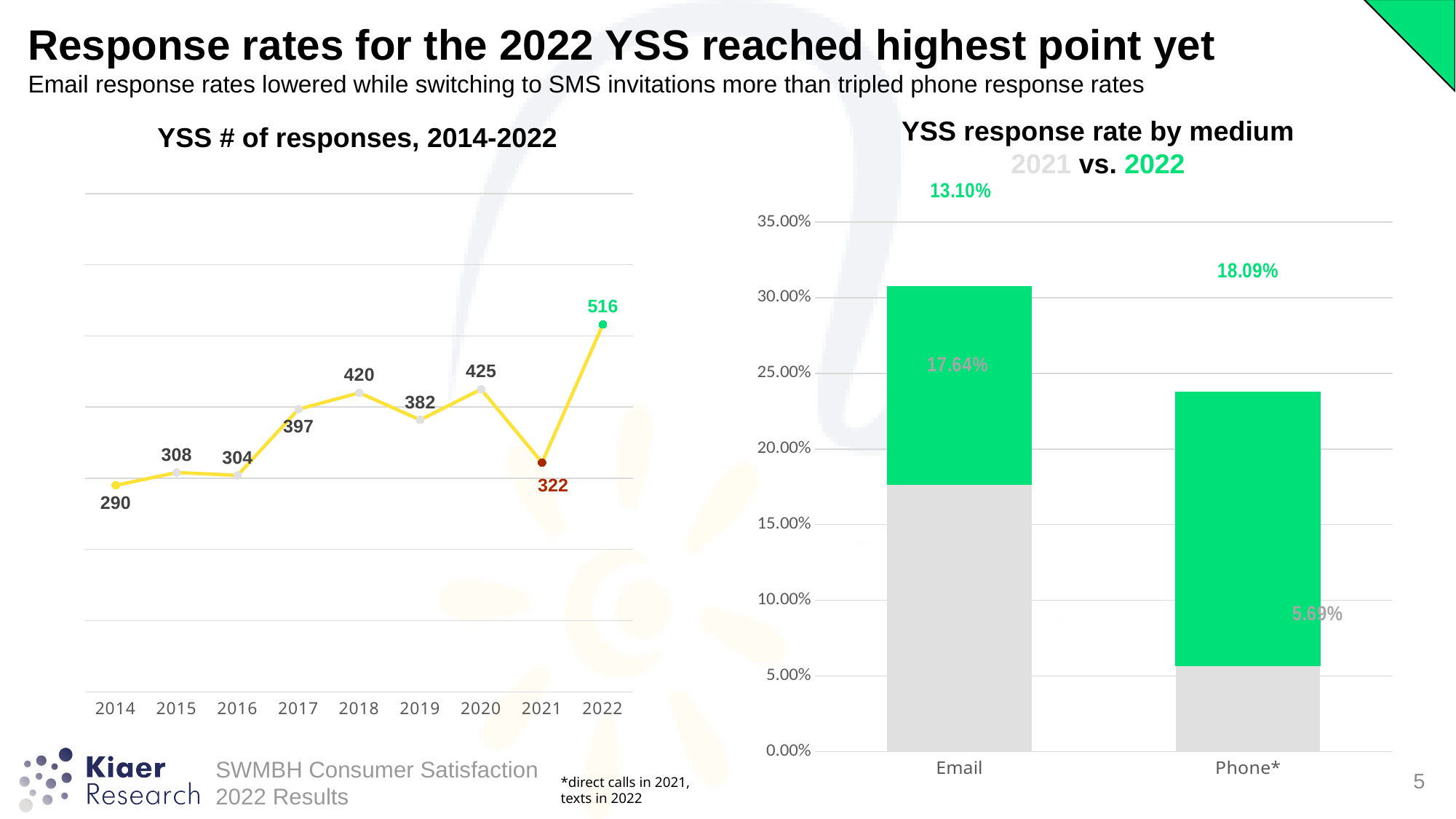
In the 'YSS response rate by medium' chart, what was the 2022 response rate for Phone*? 18.09% In the 'YSS # of responses, 2014-2022' chart, how many years are plotted? 9 In the 'YSS # of responses, 2014-2022' chart, which year had the lowest number of responses? 2014 In the 'YSS # of responses, 2014-2022' chart, what was the number of responses in 2022? 516 In the 'YSS # of responses, 2014-2022' chart, what is the difference between the 2022 and 2021 number of responses? 194 What kind of chart is 'YSS # of responses, 2014-2022'? Line chart In the 'YSS response rate by medium' chart, what was the 2021 response rate for Email? 17.64% In the 'YSS # of responses, 2014-2022' chart, which year had the highest number of responses? 2022 In the 'YSS # of responses, 2014-2022' chart, what was the number of responses in 2021? 322 In the 'YSS response rate by medium' chart, which is larger: the 2022 response rate for Email or for Phone*? Phone* In the 'YSS response rate by medium' chart, what was the 2022 response rate for Email? 13.10% In the 'YSS # of responses, 2014-2022' chart, did the number of responses rise or fall from 2020 to 2021? Fall